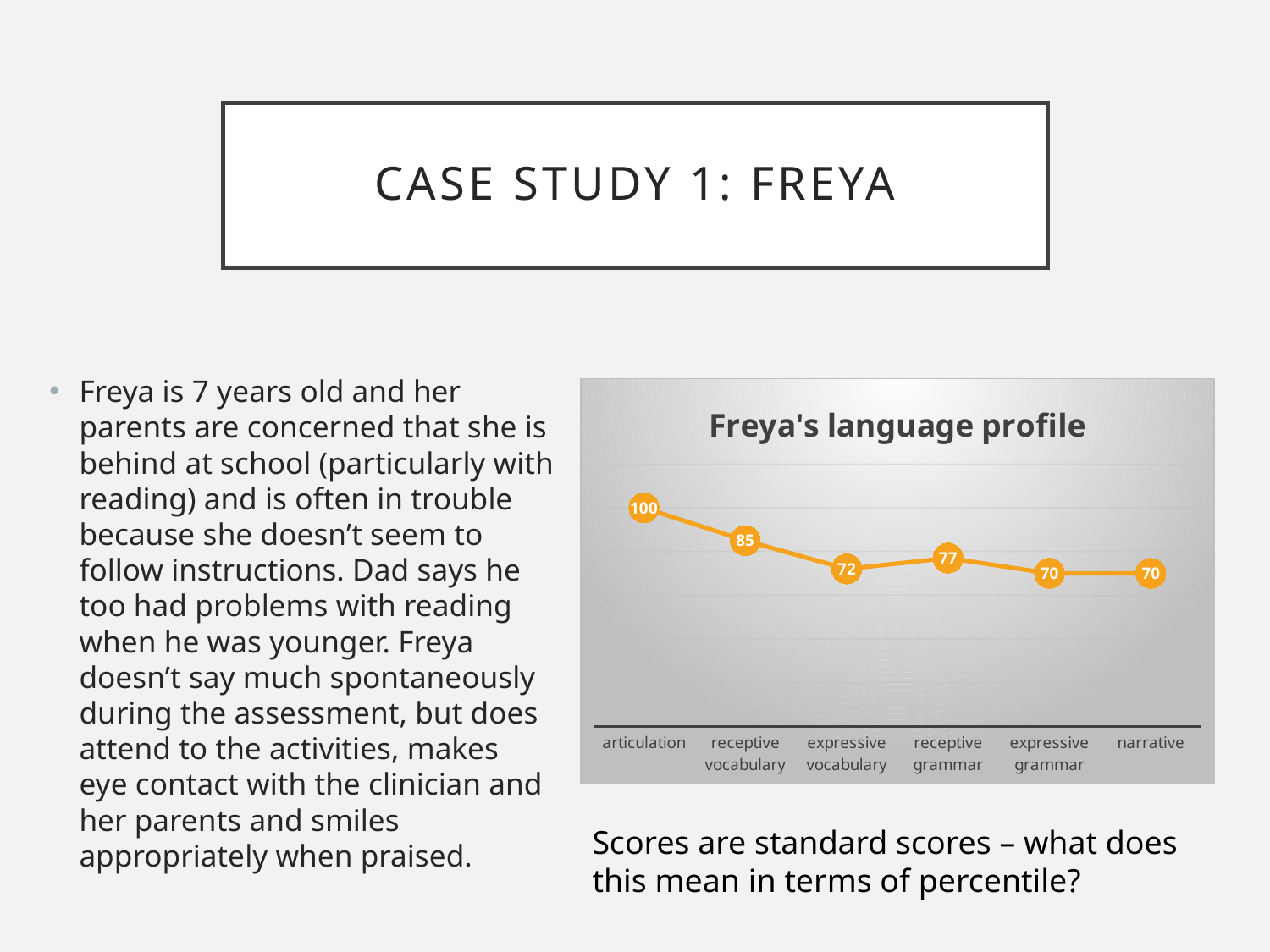
Which category has the highest value? articulation What is the value for receptive grammar? 77 What is the value for narrative? 70 What is the title of the chart? Freya's language profile What is the value for articulation in Freya's language profile? 100 Which is larger, the value for receptive grammar or the value for expressive vocabulary? receptive grammar Do the values generally rise or fall from articulation to narrative? fall What is the value for receptive vocabulary? 85 What is the value for expressive vocabulary? 72 How many categories are plotted on the x axis? 6 What is the difference between the articulation value and the receptive vocabulary value? 15 What kind of chart is shown? line chart